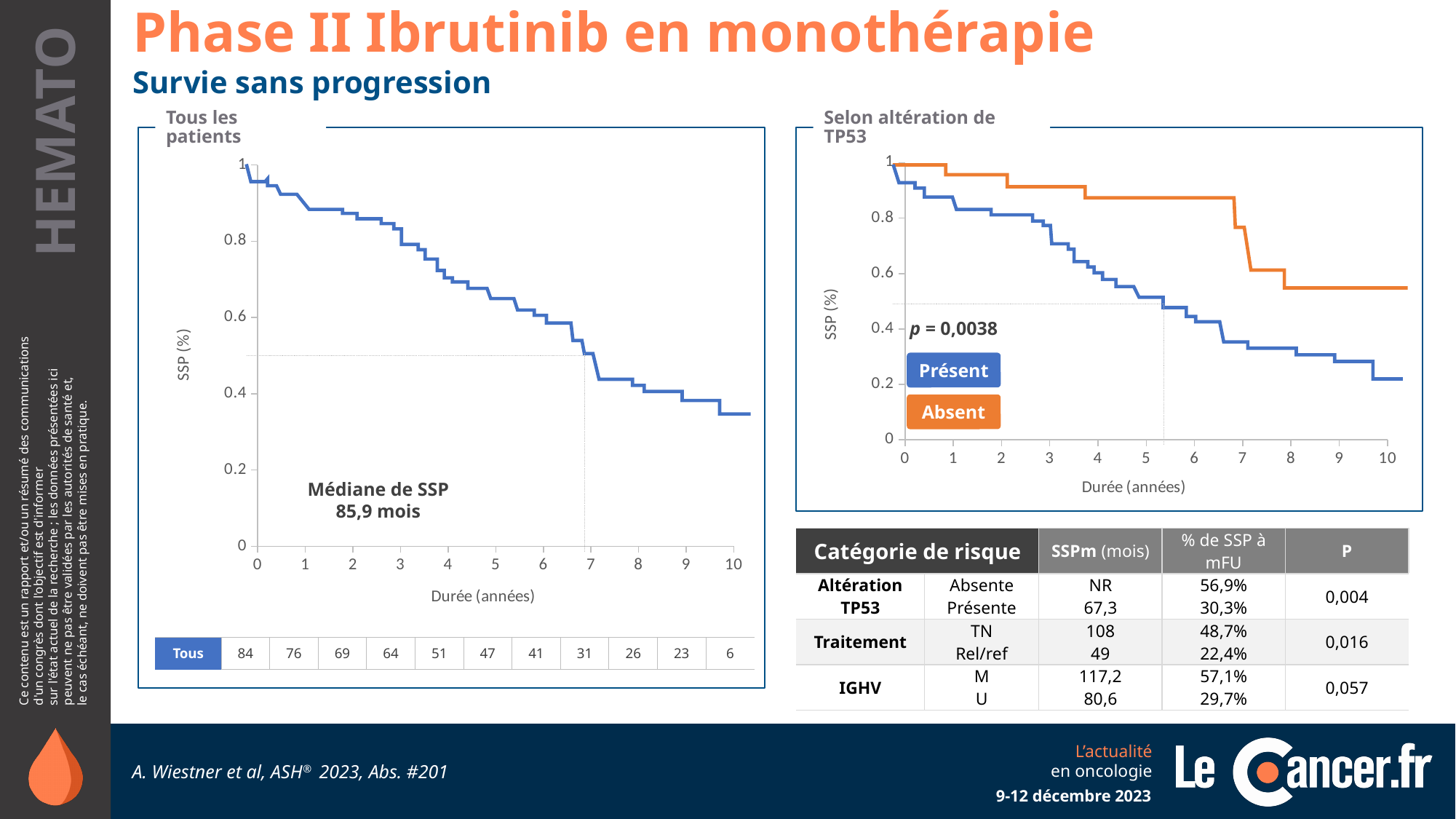
In the left chart 'Tous les patients', does the SSP curve rise or fall as the duration increases? fall In the left chart 'Tous les patients', what is the median SSP printed on the chart? 85,9 mois In the right chart 'Selon altération de TP53', what p value is printed on the chart? p = 0,0038 What kind of chart is the left chart titled 'Tous les patients'? line chart In the right chart 'Selon altération de TP53', which series has the higher SSP at 10 years, Présent or Absent? Absent How many series does the legend of the right chart 'Selon altération de TP53' list? 2 In the number-at-risk row below the left chart 'Tous les patients', how many patients are listed in the last column? 6 In the left chart 'Tous les patients', is the SSP value at 10 years greater or less than 0.4? less In the left chart 'Tous les patients', is the SSP value at 2 years greater or less than 0.8? greater In the number-at-risk row below the left chart 'Tous les patients', how many patients are listed at time 0? 84 In the right chart 'Selon altération de TP53', which colour represents the Absent series? orange In the right chart 'Selon altération de TP53', is the SSP value for Présent at 10 years greater or less than 0.4? less